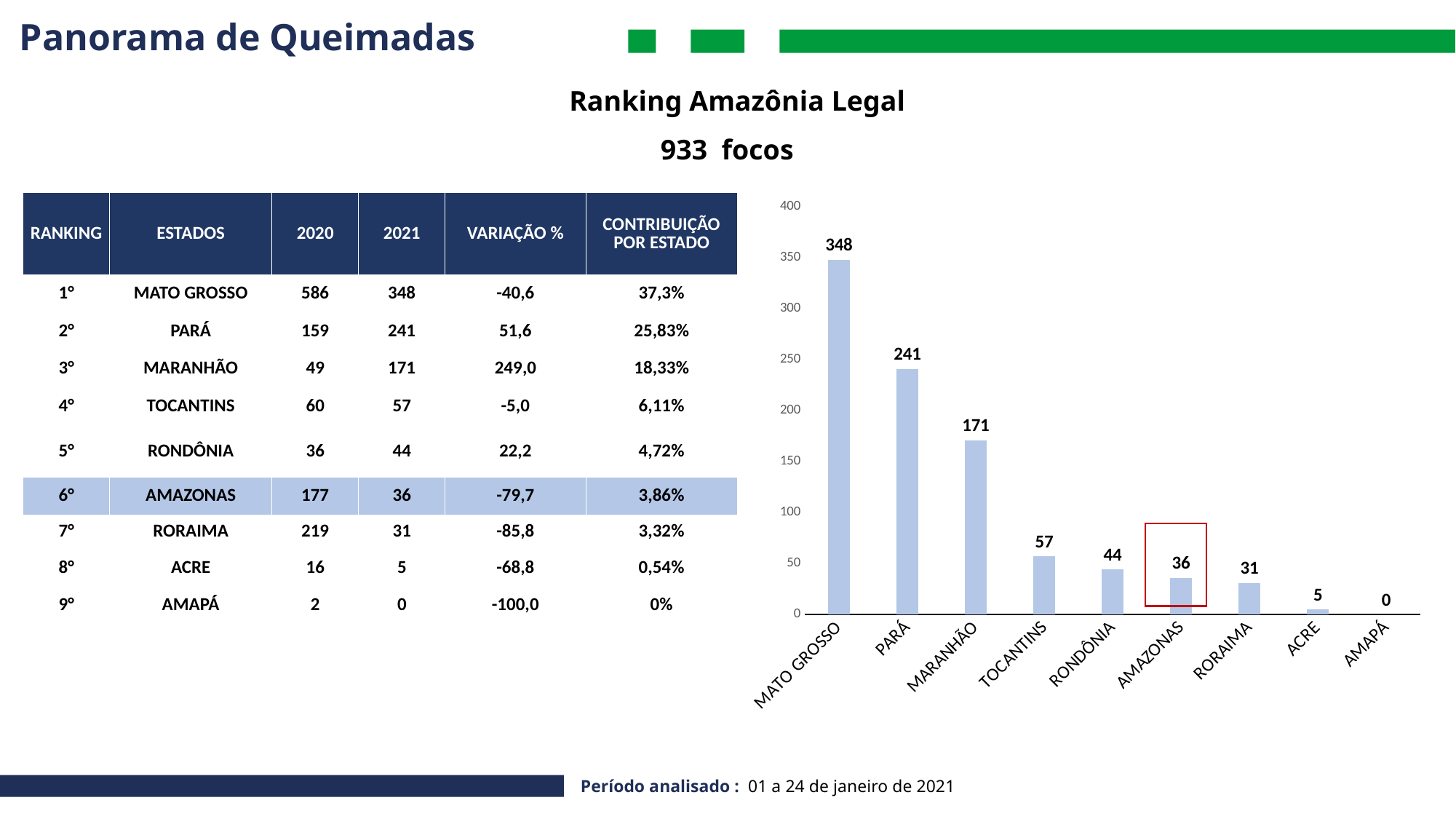
Is the value for PARÁ in the bar chart greater or less than 200? greater Which state has the highest value in the bar chart? MATO GROSSO Which bar in the chart is outlined with a red box? AMAZONAS How many states are shown in the bar chart? 9 What is the value for MARANHÃO in the bar chart? 171 What is the value for RORAIMA in the bar chart? 31 What is the difference between the values for PARÁ and MARANHÃO in the bar chart? 70 What kind of chart is shown on the slide? bar chart Which state has the lowest value in the bar chart? AMAPÁ What is the value for MATO GROSSO in the bar chart? 348 Which is larger in the bar chart, the value for TOCANTINS or the value for RONDÔNIA? TOCANTINS Do the values in the bar chart rise or fall from left to right? fall